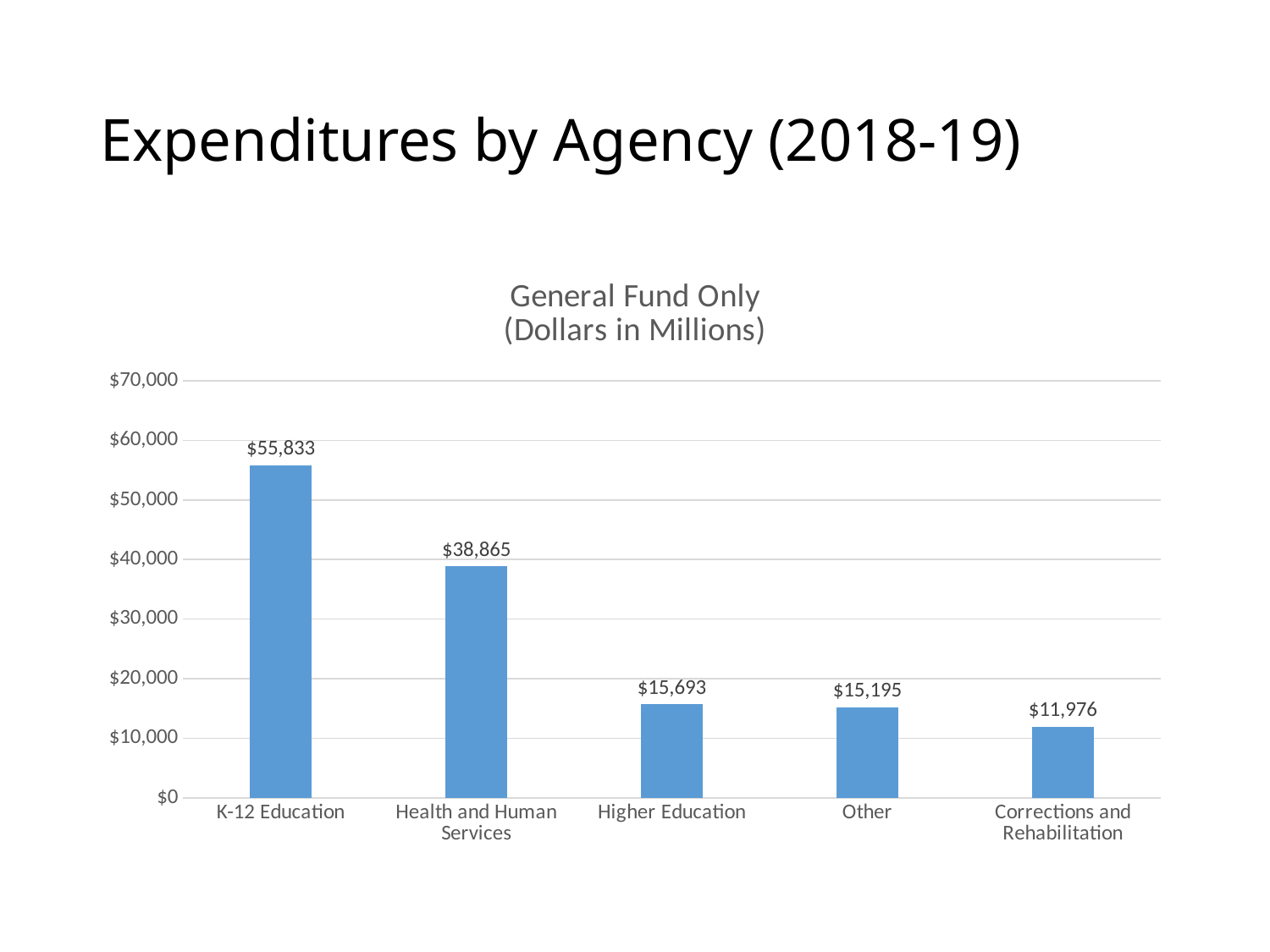
Which is larger, the value for Health and Human Services or the value for Higher Education? Health and Human Services What is the difference between the values for Higher Education and Other? $498 What is the value for Corrections and Rehabilitation? $11,976 What is the difference between the values for K-12 Education and Health and Human Services? $16,968 Is the value for Other greater or less than $20,000? less Which category has the highest value? K-12 Education Which category has the lowest value? Corrections and Rehabilitation What is the title of the chart? General Fund Only (Dollars in Millions) What is the value for K-12 Education? $55,833 What is the value for Health and Human Services? $38,865 What kind of chart is shown on the slide? bar chart How many categories are shown on the x axis? 5